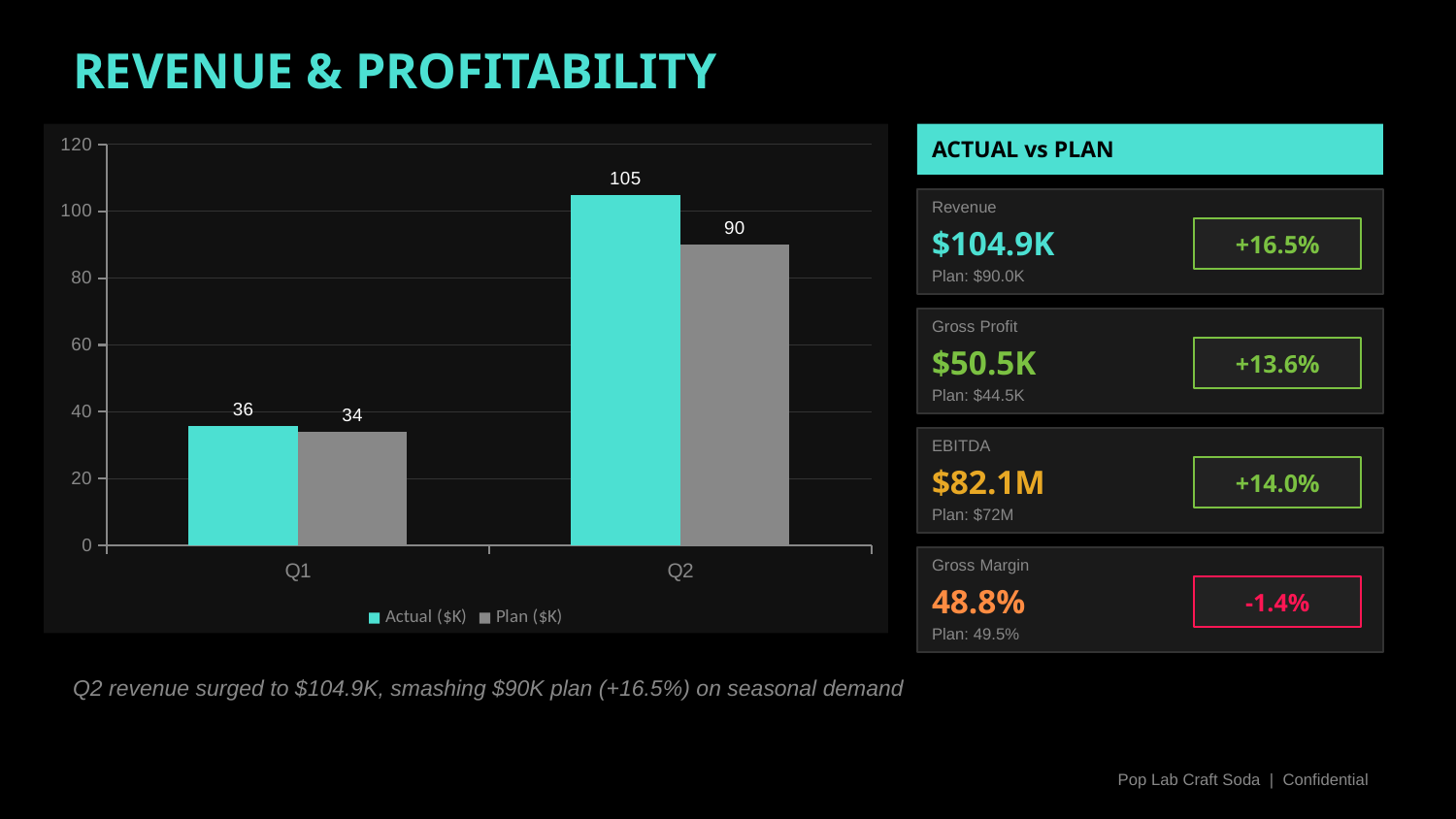
What is the Actual ($K) value for Q1? 36 What is the Plan ($K) value for Q1? 34 How many quarters are shown on the x axis of the chart? 2 Does the Actual ($K) value rise or fall from Q1 to Q2? Rise How many series does the chart legend list? 2 What is the Plan ($K) value for Q2? 90 Which is larger in Q1, the Actual ($K) value or the Plan ($K) value? Actual ($K) What is the difference between the Actual ($K) and Plan ($K) values for Q2? 15 Which quarter has the lowest Plan ($K) value? Q1 What kind of chart is shown on the slide? Bar chart What is the Actual ($K) value for Q2? 105 Which quarter has the highest Actual ($K) value? Q2